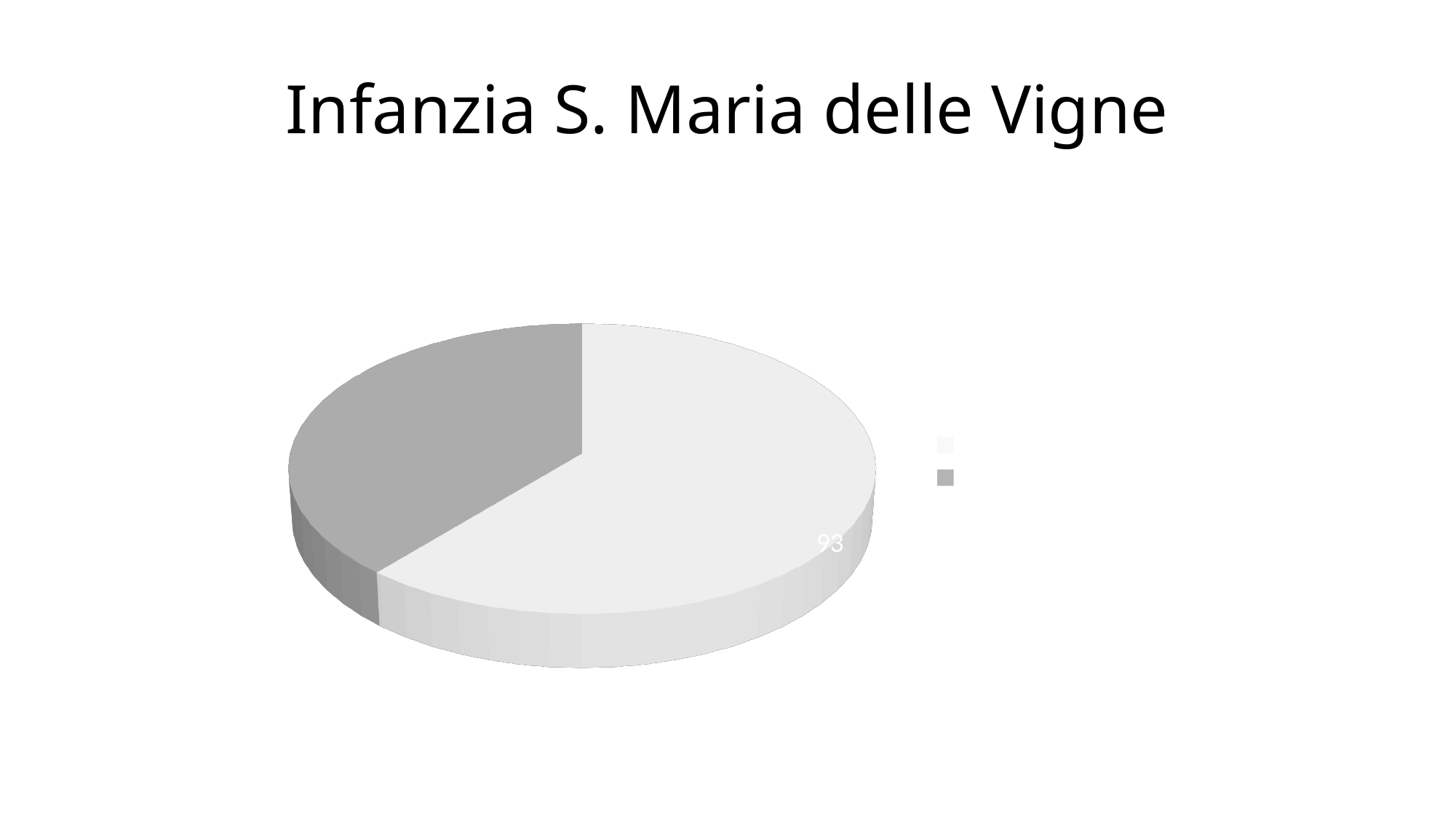
How many slices does the pie chart have? 2 Is the light-coloured slice more or less than half of the pie? more Which slice of the pie is the smallest? the dark grey slice How many entries does the legend list? 2 Which slice is larger, the light-coloured slice or the dark grey slice? the light-coloured slice What value is printed on the light-coloured slice of the pie? 93 Which slice of the pie is the largest? the light-coloured slice What kind of chart is shown on the slide? pie chart What is the title of the chart? Infanzia S. Maria delle Vigne